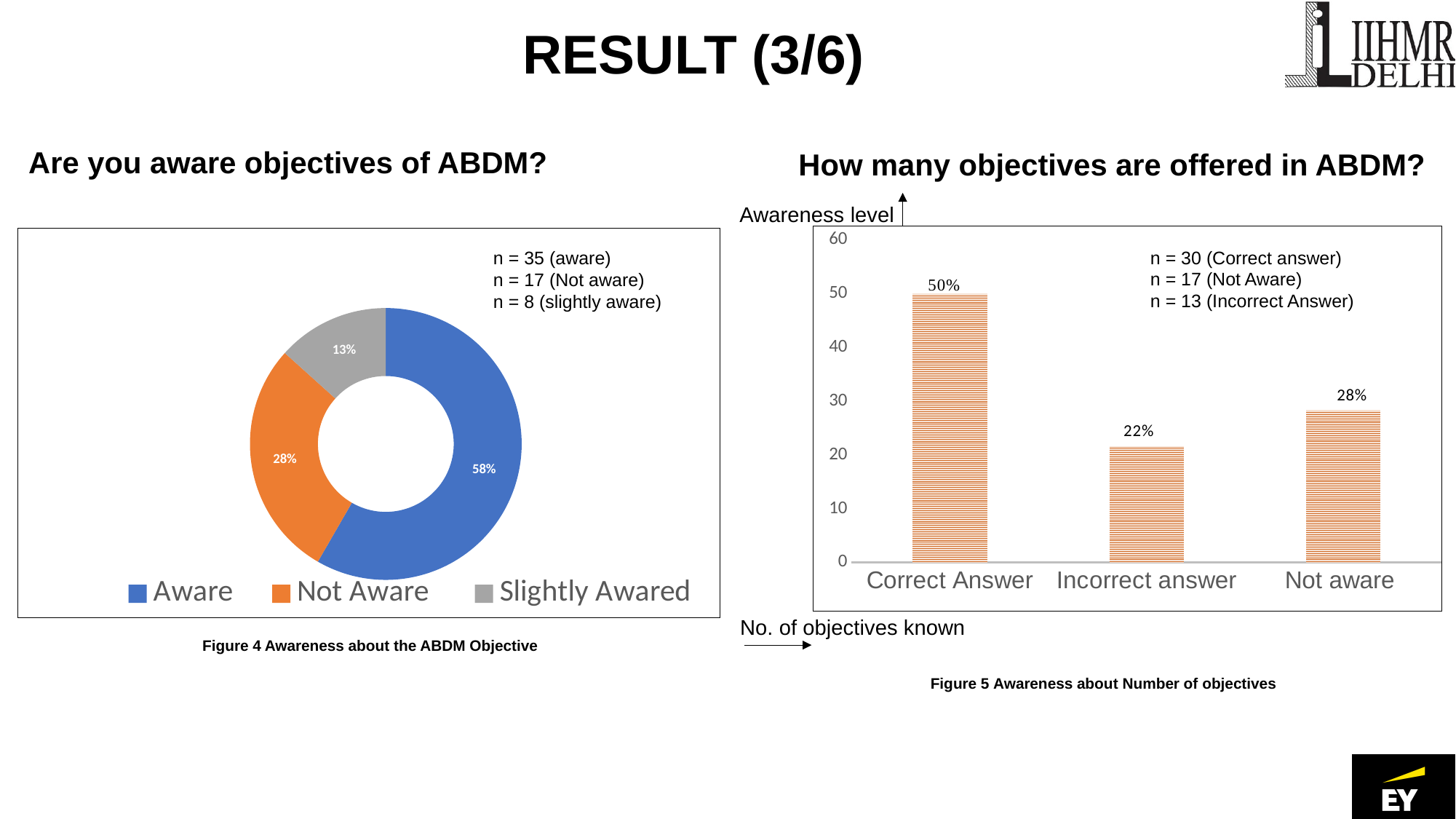
In the left chart (Are you aware objectives of ABDM?), what percentage is shown for Aware? 58% In the right chart (How many objectives are offered in ABDM?), what is the difference in percentage points between Correct Answer and Not aware? 22 In the right chart (How many objectives are offered in ABDM?), what kind of chart is shown? Bar chart In the left chart (Are you aware objectives of ABDM?), which category has the smallest share? Slightly Awared In the left chart (Are you aware objectives of ABDM?), what kind of chart is shown? Doughnut (pie) chart In the right chart (How many objectives are offered in ABDM?), what percentage is shown for Correct Answer? 50% In the right chart (How many objectives are offered in ABDM?), which category has the highest value? Correct Answer In the left chart (Are you aware objectives of ABDM?), what percentage is shown for Not Aware? 28% In the left chart (Are you aware objectives of ABDM?), how many categories does the legend list? 3 In the left chart (Are you aware objectives of ABDM?), what is the difference in percentage points between Aware and Not Aware? 30 In the right chart (How many objectives are offered in ABDM?), what percentage is shown for Incorrect answer? 22% In the right chart (How many objectives are offered in ABDM?), which is larger: Incorrect answer or Not aware? Not aware